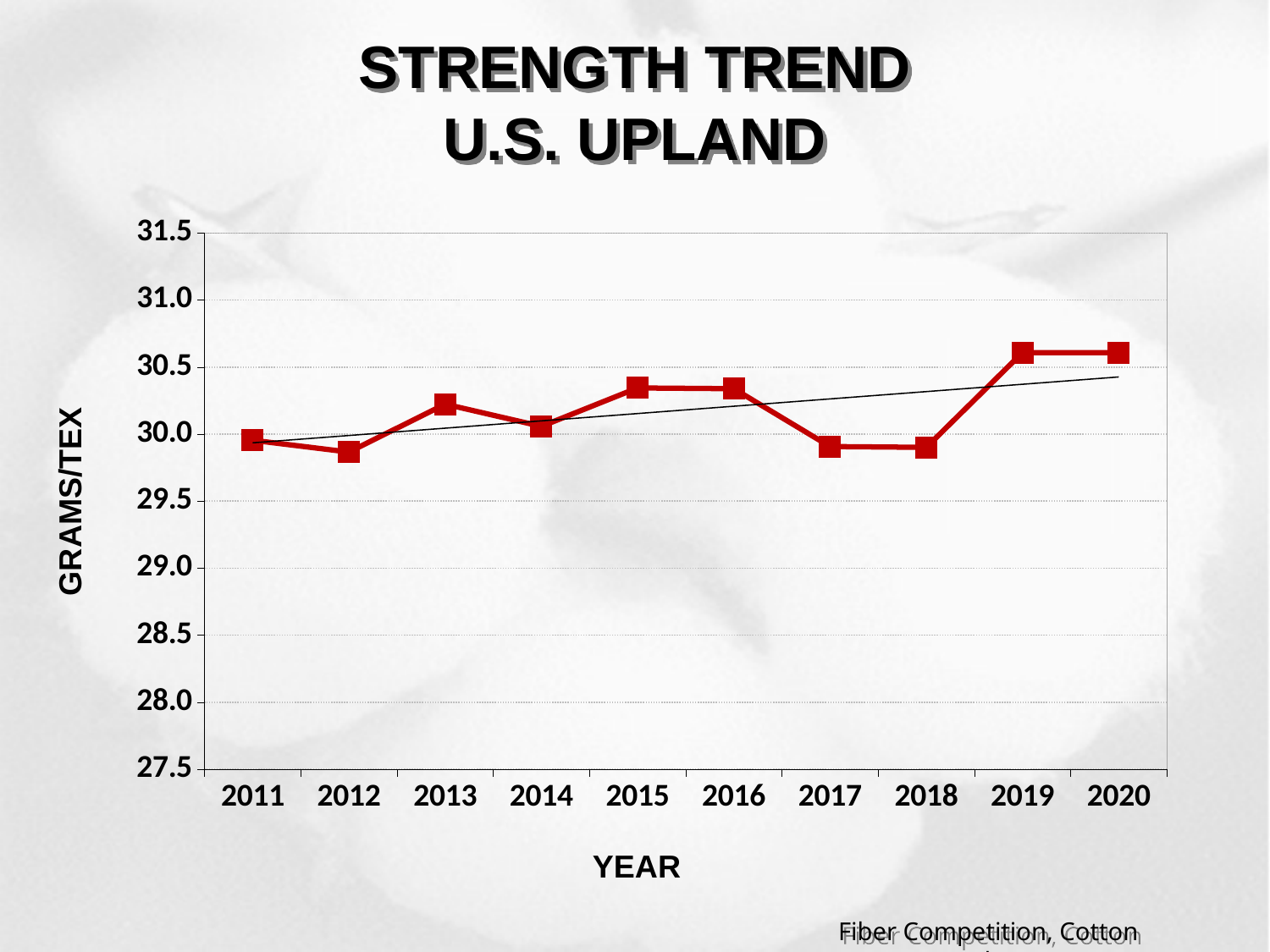
Is the value for 2018 greater or less than 30.5? less Which year has the larger value, 2012 or 2013? 2013 Is the value for 2015 greater or less than 30.0? greater What kind of chart is shown on the slide? line chart What is the title of the chart? STRENGTH TREND U.S. UPLAND Is the value for 2012 greater or less than 30.0? less Which year has the larger value, 2015 or 2017? 2015 How many years are plotted on the x axis? 10 Does the fitted trend line rise or fall from 2011 to 2020? rise What is the label on the y axis? GRAMS/TEX